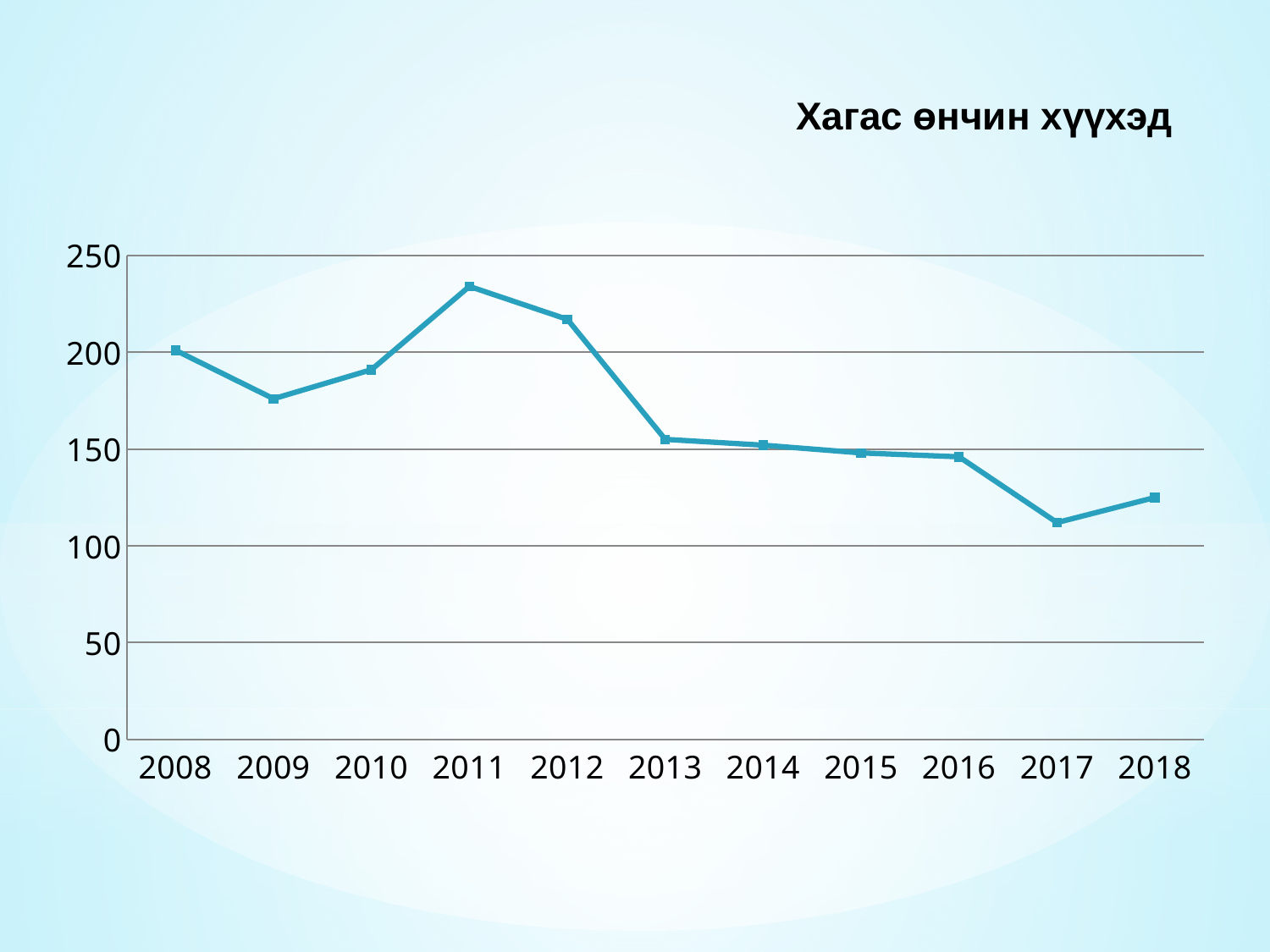
Which is larger, the value for 2012 or the value for 2013? 2012 Overall, do the values rise or fall from 2008 to 2018? fall Is the value for 2011 greater or less than 200? greater Is the value for 2009 greater or less than 200? less Which is larger, the value for 2018 or the value for 2017? 2018 How many years are plotted along the x axis? 11 What kind of chart is shown on the slide? line chart Is the value for 2017 greater or less than 150? less Which year has the lowest value? 2017 Which year has the highest value? 2011 What is the title of the chart? Хагас өнчин хүүхэд